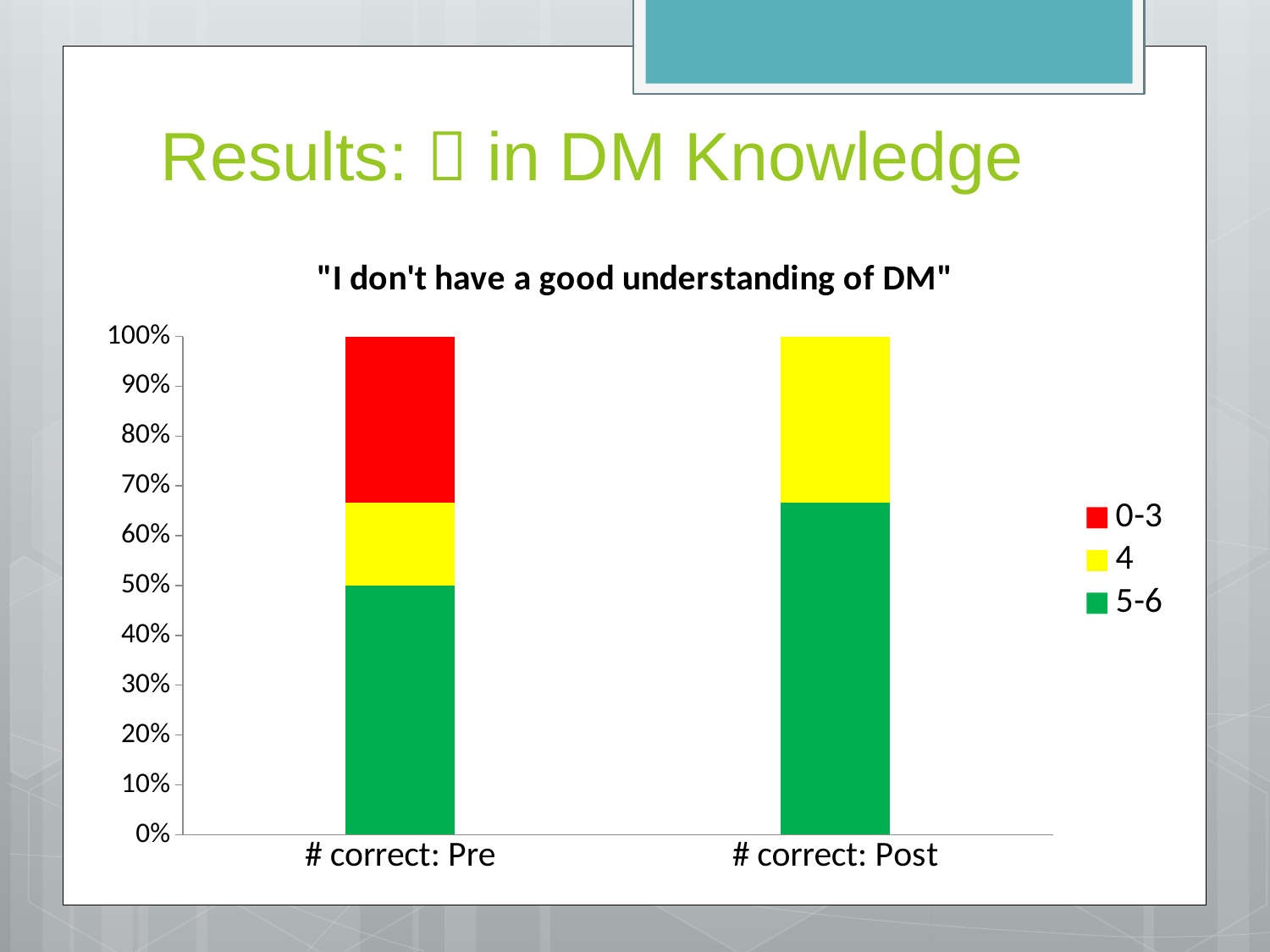
Which colour represents the 0-3 series in the legend? Red Is the 5-6 segment for '# correct: Post' greater or less than 60%? greater How many series does the legend list? 3 What share of the '# correct: Pre' bar is the 5-6 segment? 50% Which bar has the larger 5-6 segment, '# correct: Pre' or '# correct: Post'? # correct: Post What is the title of the chart? "I don't have a good understanding of DM" How many categories are shown on the x axis? 2 What is the total of the stacked bar for '# correct: Pre'? 100% Is the 0-3 segment for '# correct: Pre' greater or less than 40%? less What kind of chart is shown on the slide? Stacked bar chart Is the 4 segment for '# correct: Post' greater or less than 20%? greater